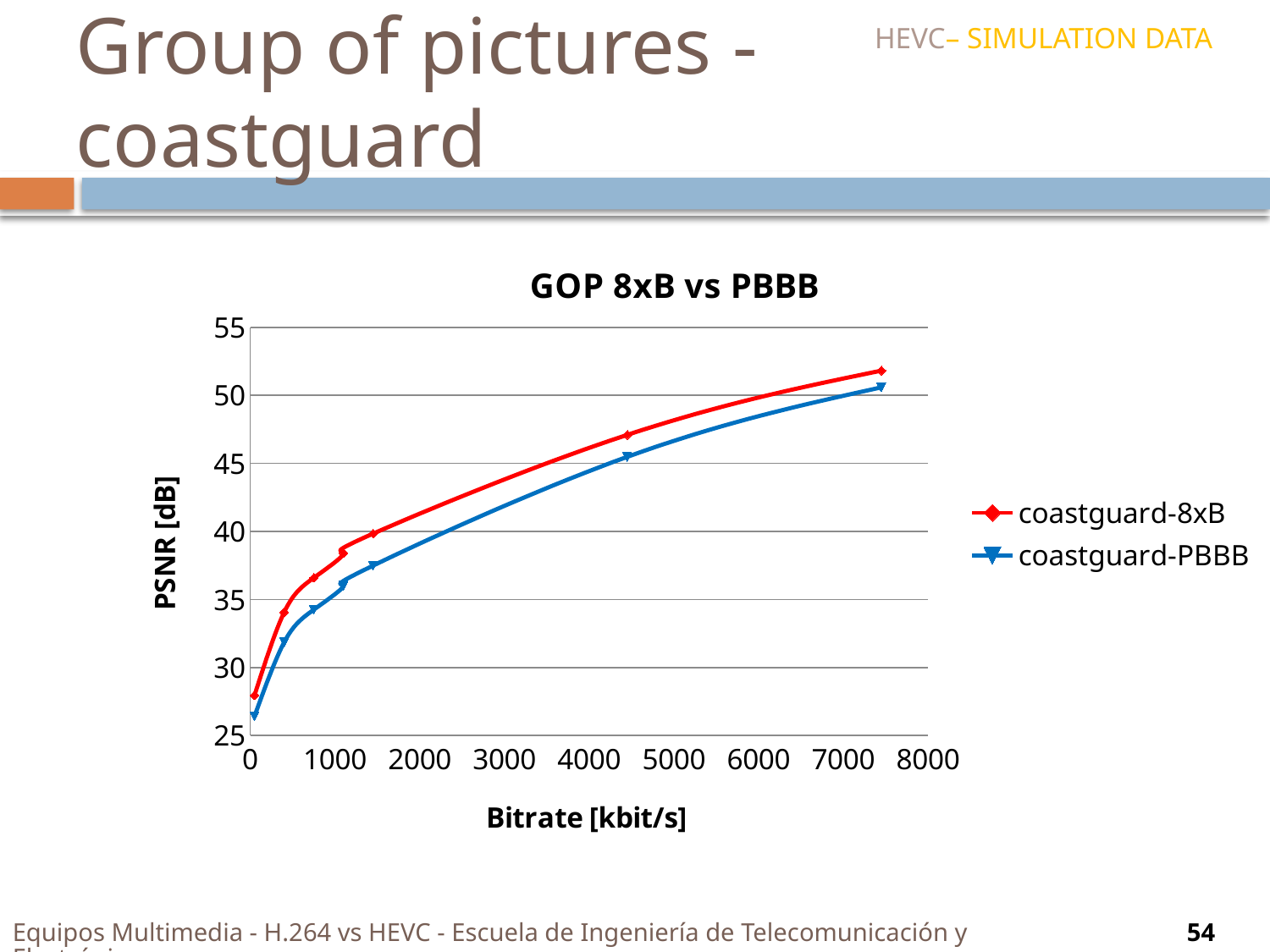
What is the title of the chart? GOP 8xB vs PBBB How many series does the legend list? 2 Is the PSNR for coastguard-PBBB at its lowest bitrate point greater or less than 30? less Which series has the lower PSNR at the lowest bitrate shown, coastguard-8xB or coastguard-PBBB? coastguard-PBBB Is the PSNR for coastguard-8xB at a bitrate of about 4500 kbit/s greater or less than 45? greater What kind of chart is shown on the slide? Line chart Is the PSNR for coastguard-8xB at its highest bitrate point greater or less than 50? greater Does the PSNR for coastguard-PBBB rise or fall as bitrate increases? Rise Does the PSNR for coastguard-8xB rise or fall as bitrate increases? Rise Which series has the higher PSNR at a bitrate of about 4500 kbit/s, coastguard-8xB or coastguard-PBBB? coastguard-8xB What are the two series named in the legend? coastguard-8xB and coastguard-PBBB